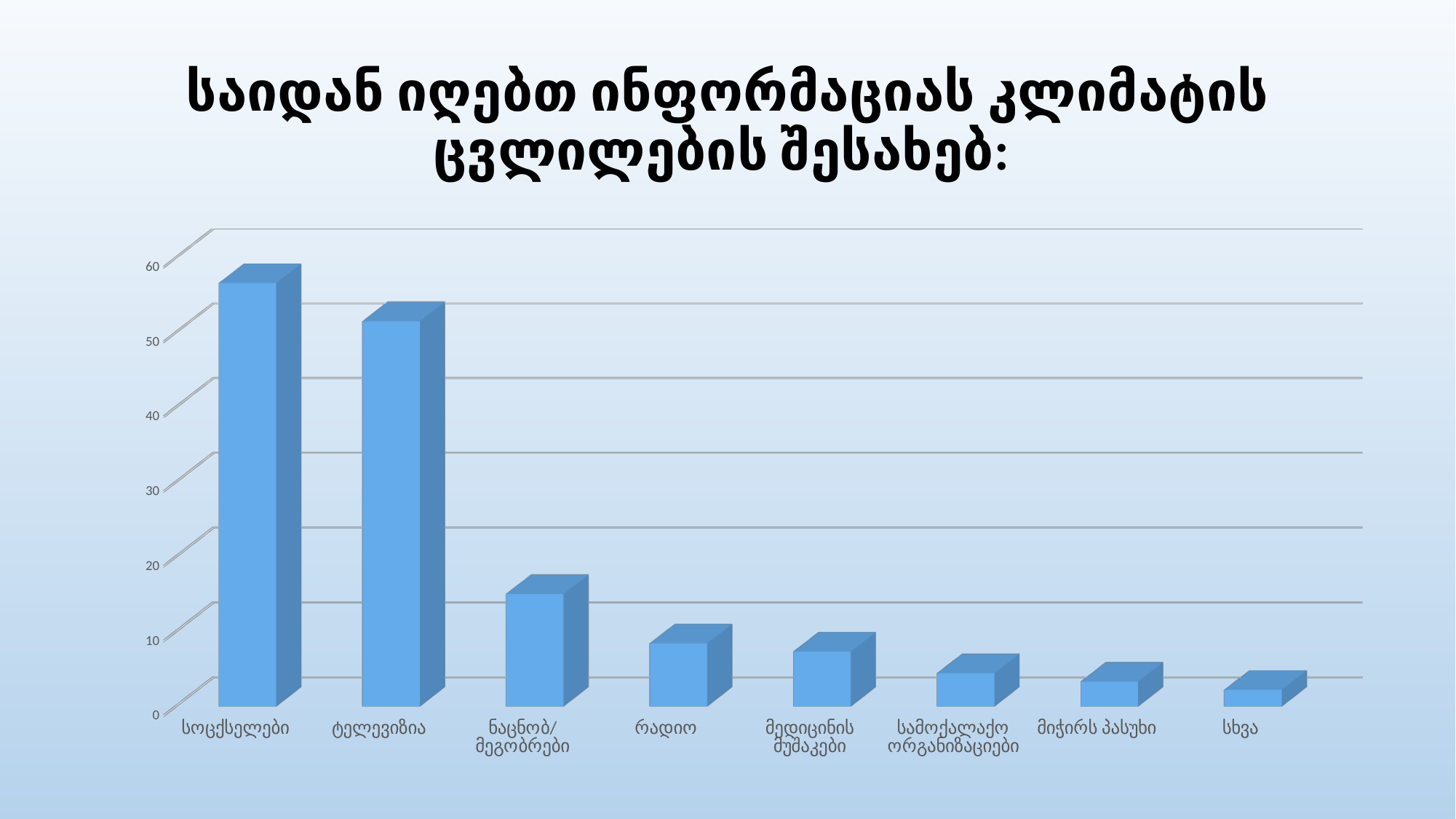
How many categories are shown on the x axis of the chart? 8 Which is larger, the value for სოცქსელები or the value for ტელევიზია? სოცქსელები What kind of chart is shown on the slide? bar chart What is the title of the slide? საიდან იღებთ ინფორმაციას კლიმატის ცვლილების შესახებ: Is the value for სოცქსელები greater or less than 50? greater Is the value for რადიო greater or less than 20? less Is the value for სამოქალაქო ორგანიზაციები greater or less than 10? less Which category has the highest value in the chart? სოცქსელები Do the values rise or fall from left to right along the x axis? fall Which is larger, the value for ნაცნობ/მეგობრები or the value for რადიო? ნაცნობ/მეგობრები